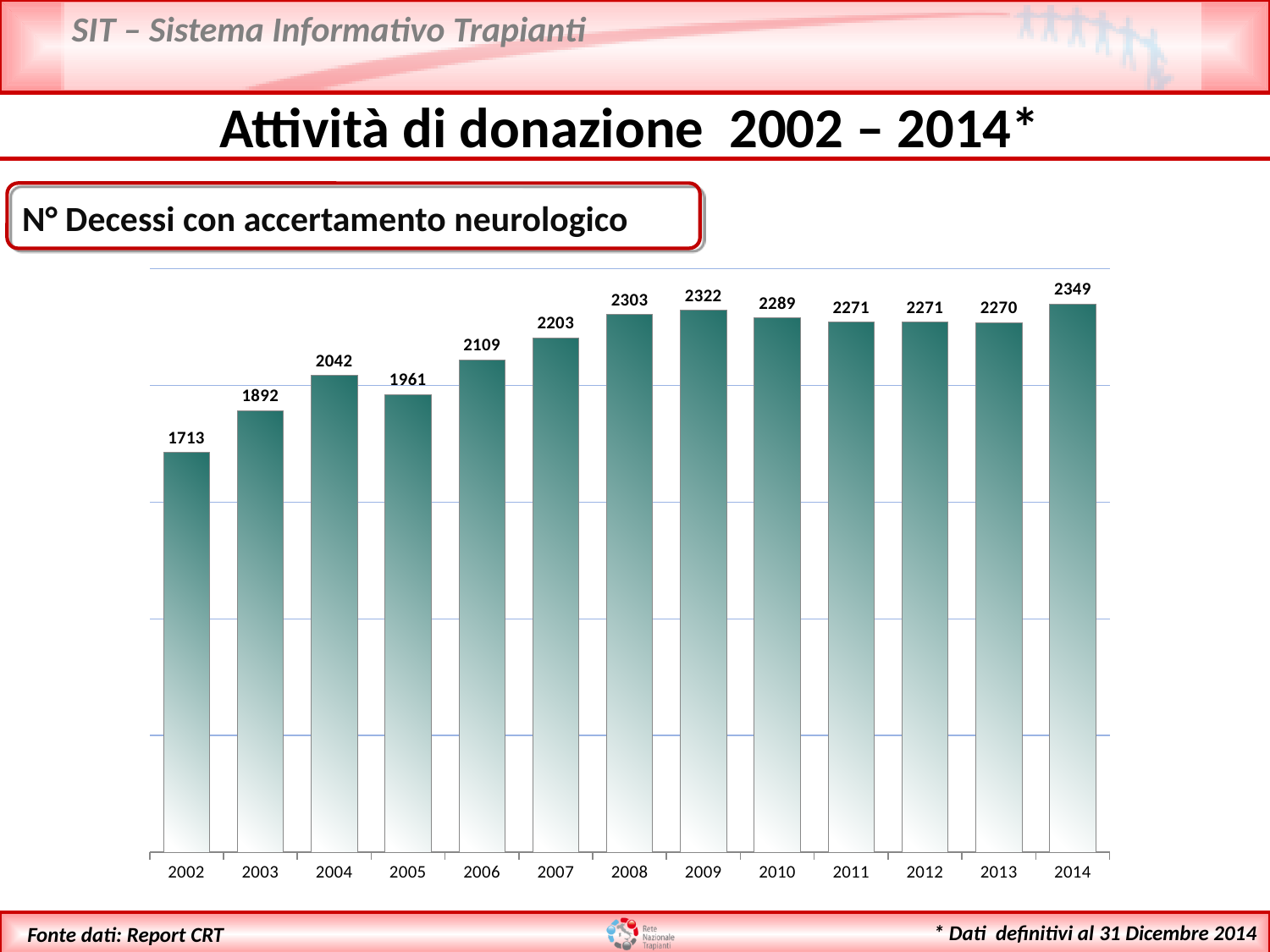
What kind of chart is shown on the slide? Bar chart Which year has a larger value, 2008 or 2010? 2008 What is the title shown in the box above the chart? N° Decessi con accertamento neurologico What is the difference between the values for 2004 and 2005? 81 What is the difference between the values for 2014 and 2002? 636 How many years are shown on the x axis of the chart? 13 Which year has the lowest value in the chart? 2002 What value is shown for 2014 in the chart? 2349 What is the number of deaths with neurological assessment (N° Decessi con accertamento neurologico) in 2002? 1713 What value is shown for 2009 in the chart? 2322 Do the values rise or fall from 2002 to 2009? Rise Which year has the highest value in the chart? 2014